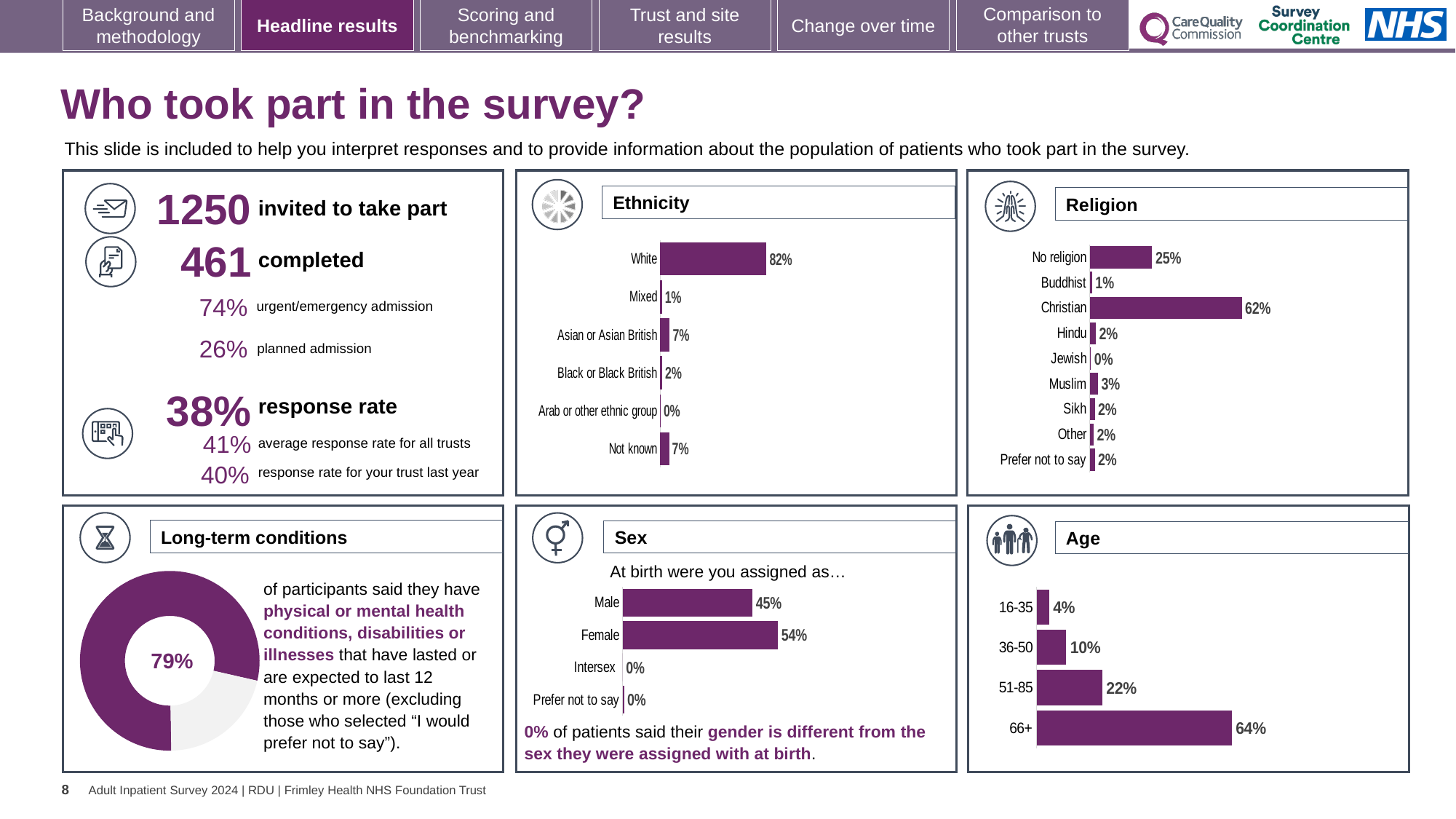
In the Sex chart, which is larger, Male or Female? Female In the Religion chart, what is the value for No religion? 25% How many categories does the Ethnicity chart show? 6 What kind of chart is the Long-term conditions chart? Doughnut chart In the Long-term conditions chart, what share of participants said they have long-term conditions? 79% In the Ethnicity chart, which category has the lowest value? Arab or other ethnic group In the Ethnicity chart, what percentage of respondents are White? 82% How many categories does the Religion chart show? 9 In the Religion chart, which category has the highest value? Christian In the Age chart, what is the value for 36-50? 10% In the Age chart, do the values rise or fall from 16-35 to 66+? Rise In the Age chart, what is the difference between the 66+ and 51-85 values? 42%